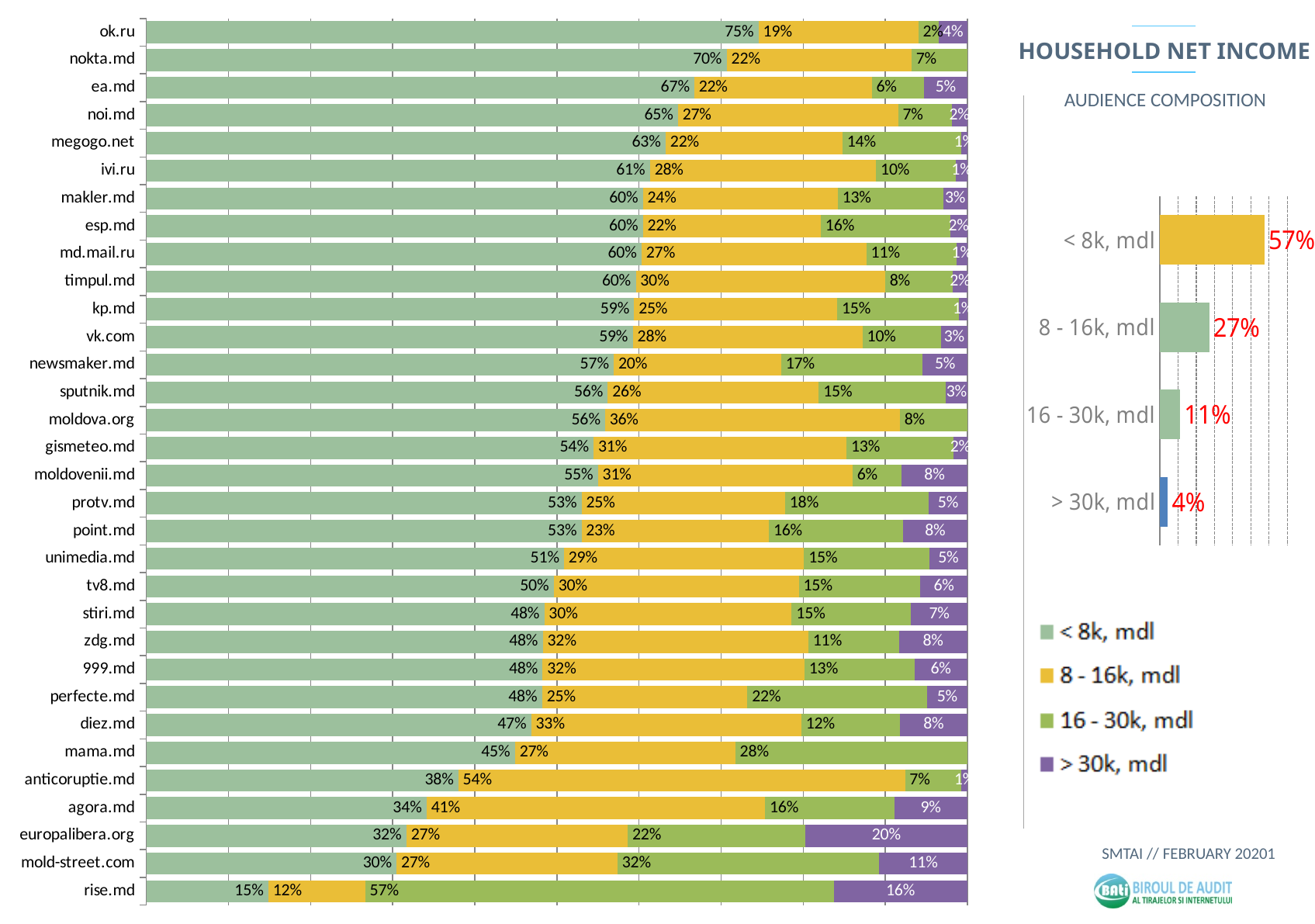
In the large stacked bar chart on the left, what share of ok.ru's audience is in the '< 8k, mdl' group? 75% In the large stacked bar chart on the left, which website has the highest share of audience in the '< 8k, mdl' group? ok.ru In the Household Net Income chart on the right, what is the difference between the '< 8k, mdl' value and the '8 - 16k, mdl' value? 30 percentage points In the large stacked bar chart on the left, which has a larger '8 - 16k, mdl' share: anticoruptie.md or agora.md? anticoruptie.md In the large stacked bar chart on the left, which website has the lowest share of audience in the '< 8k, mdl' group? rise.md In the large stacked bar chart on the left, what share of europalibera.org's audience is in the '> 30k, mdl' group? 20% How many income groups does the legend of the large stacked bar chart list? 4 How many websites are shown in the large stacked bar chart on the left? 32 In the Household Net Income chart on the right, which income category has the lowest value? > 30k, mdl In the Household Net Income chart on the right, which income category has the highest value? < 8k, mdl In the large stacked bar chart on the left, what share of rise.md's audience is in the '16 - 30k, mdl' group? 57% In the Household Net Income chart on the right, what is the value for the '< 8k, mdl' category? 57%